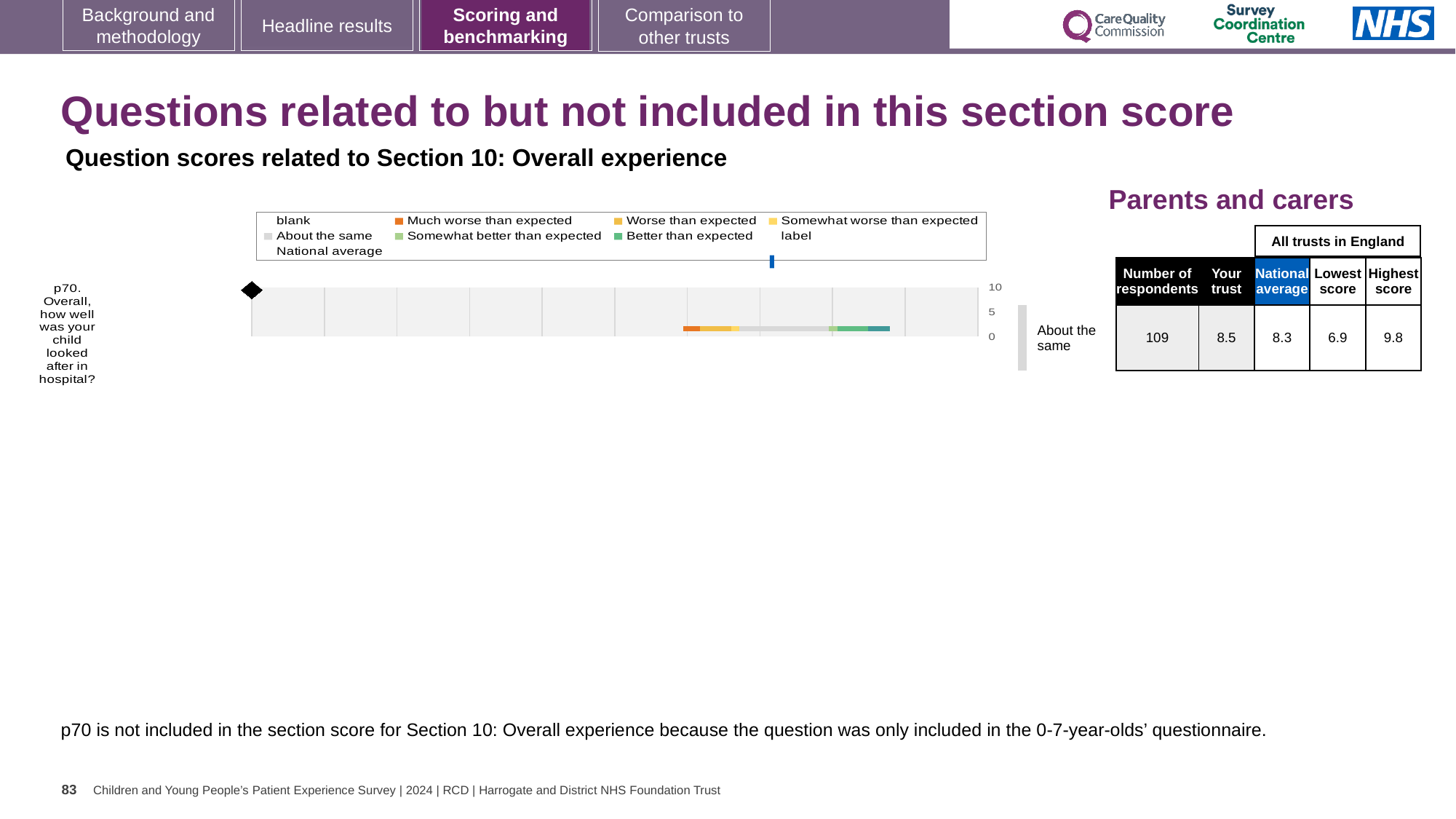
Which question is plotted in the chart? p70. Overall, how well was your child looked after in hospital? In the table next to the chart, what is the lowest score among all trusts in England for p70? 6.9 In the table next to the chart, what is the number of respondents for p70? 109 What is the highest tick value shown on the chart's axis? 10 In the table next to the chart, what is the 'Your trust' score for p70? 8.5 In the table next to the chart, which is larger for p70: the 'Your trust' score or the national average? Your trust What result label is shown to the right of the bar for p70? About the same How many questions are plotted in the chart? 1 In the table next to the chart, what is the national average score for p70? 8.3 In the table next to the chart, what is the highest score among all trusts in England for p70? 9.8 In the table next to the chart, what is the difference between the highest score and the lowest score for p70? 2.9 What kind of chart is shown on the slide? bar chart